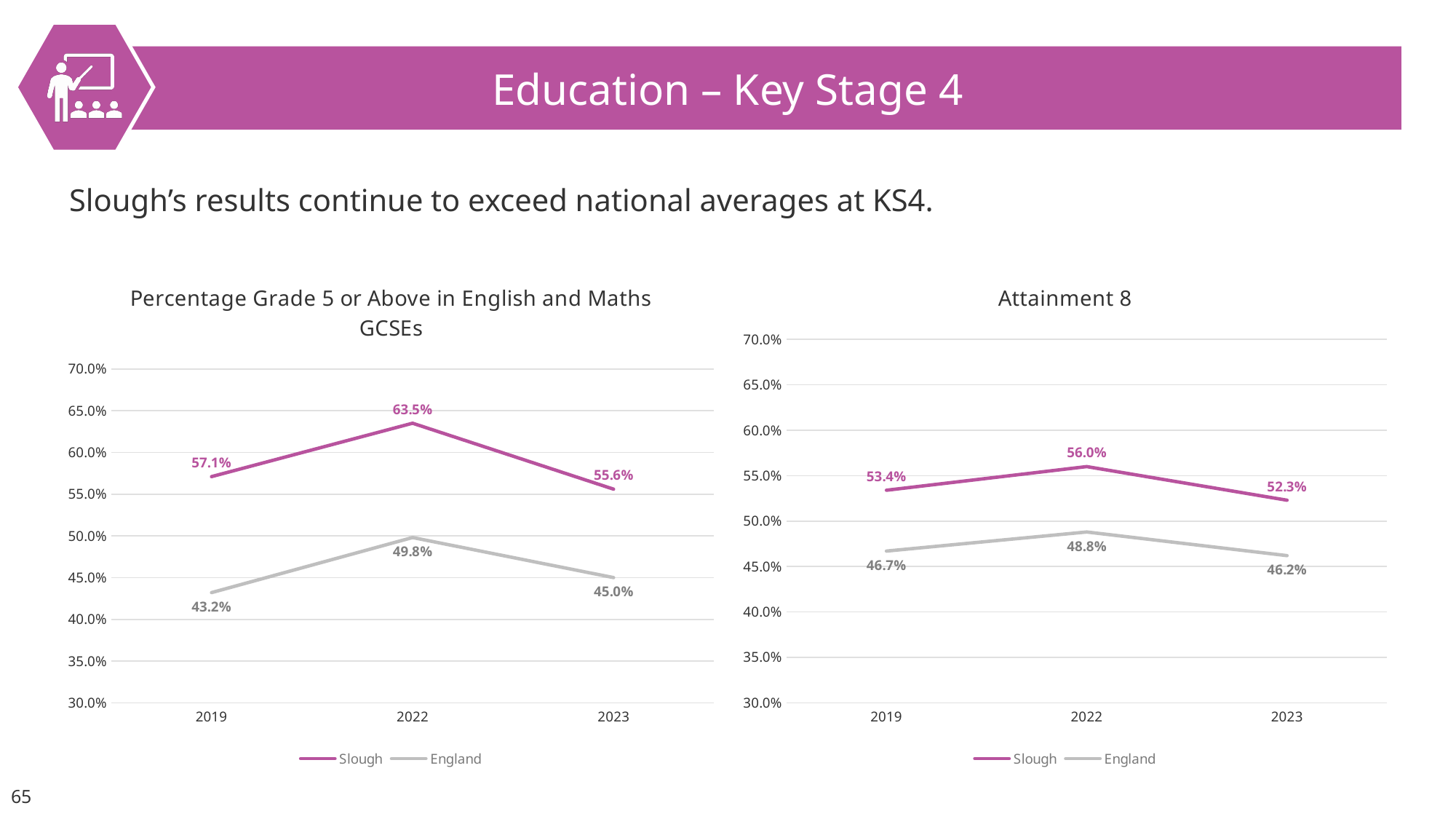
In the 'Attainment 8' chart, what is the difference between Slough and England in 2019? 6.7% In the 'Percentage Grade 5 or Above in English and Maths GCSEs' chart, what is the value for Slough in 2022? 63.5% What kind of chart is the 'Percentage Grade 5 or Above in English and Maths GCSEs' chart? Line chart In the 'Attainment 8' chart, what is the value for England in 2022? 48.8% In the 'Percentage Grade 5 or Above in English and Maths GCSEs' chart, what is the difference between Slough and England in 2023? 10.6% In the 'Percentage Grade 5 or Above in English and Maths GCSEs' chart, what is the value for England in 2019? 43.2% In the 'Percentage Grade 5 or Above in English and Maths GCSEs' chart, which year has the highest value for Slough? 2022 In the 'Attainment 8' chart, which year has the lowest value for England? 2023 In the 'Attainment 8' chart, which is larger in 2022: Slough or England? Slough In the 'Attainment 8' chart, what is the value for Slough in 2023? 52.3% In the 'Percentage Grade 5 or Above in English and Maths GCSEs' chart, how many years are shown on the x axis? 3 How many series does the legend of the 'Attainment 8' chart list? 2